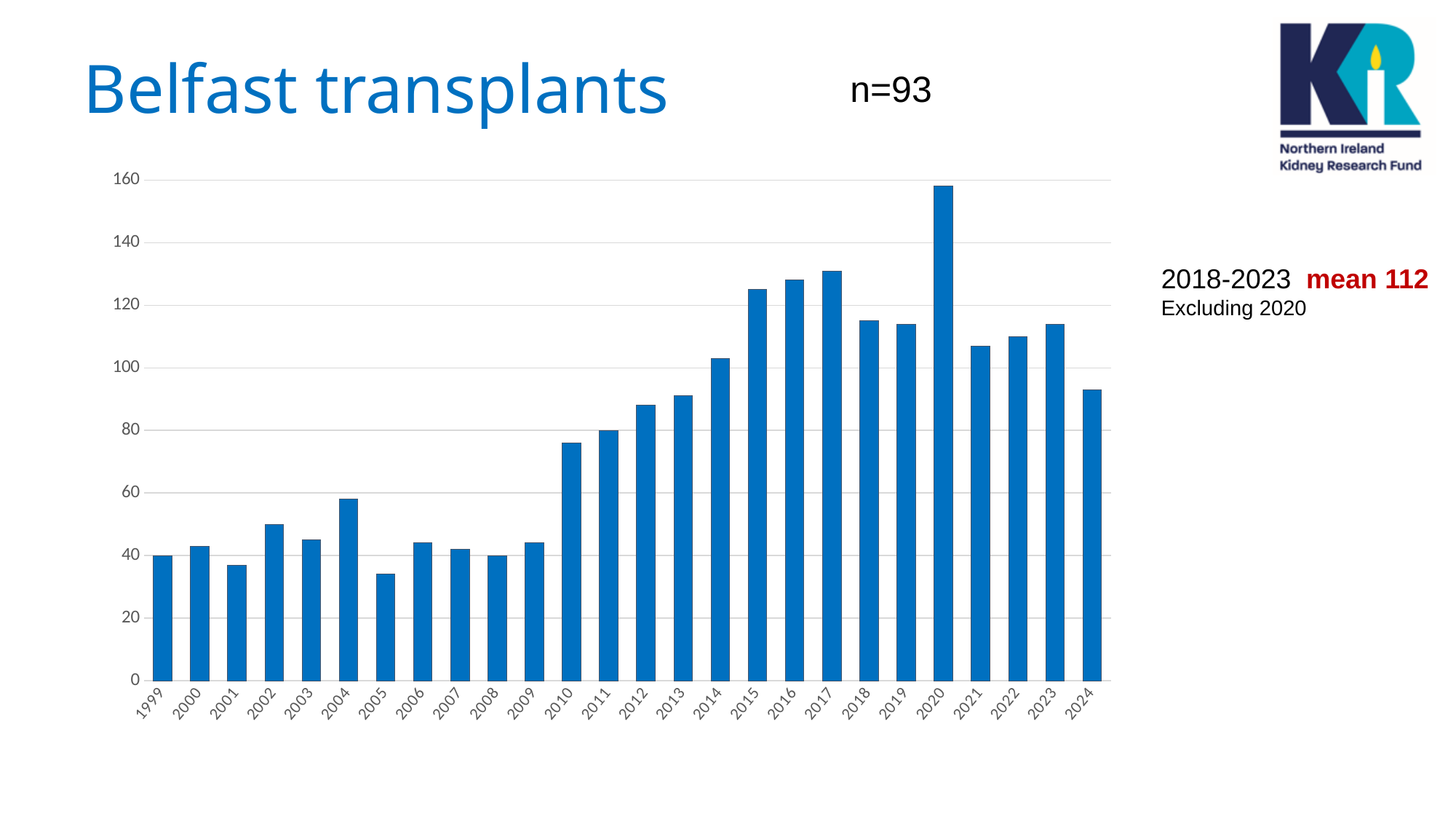
What mean value is stated on the slide for 2018-2023 excluding 2020? 112 Is the value for 2024 greater or less than 100? less How many years are shown on the x axis? 26 Which year has the highest number of transplants? 2020 Do the values rise or fall from 2010 to 2017? rise Is the value for 2020 greater or less than 140? greater Is the value for 2017 greater or less than 120? greater What is the title of the chart? Belfast transplants Which year has the larger value, 2004 or 2005? 2004 What kind of chart is shown on the slide? bar chart Which year has the lowest number of transplants? 2005